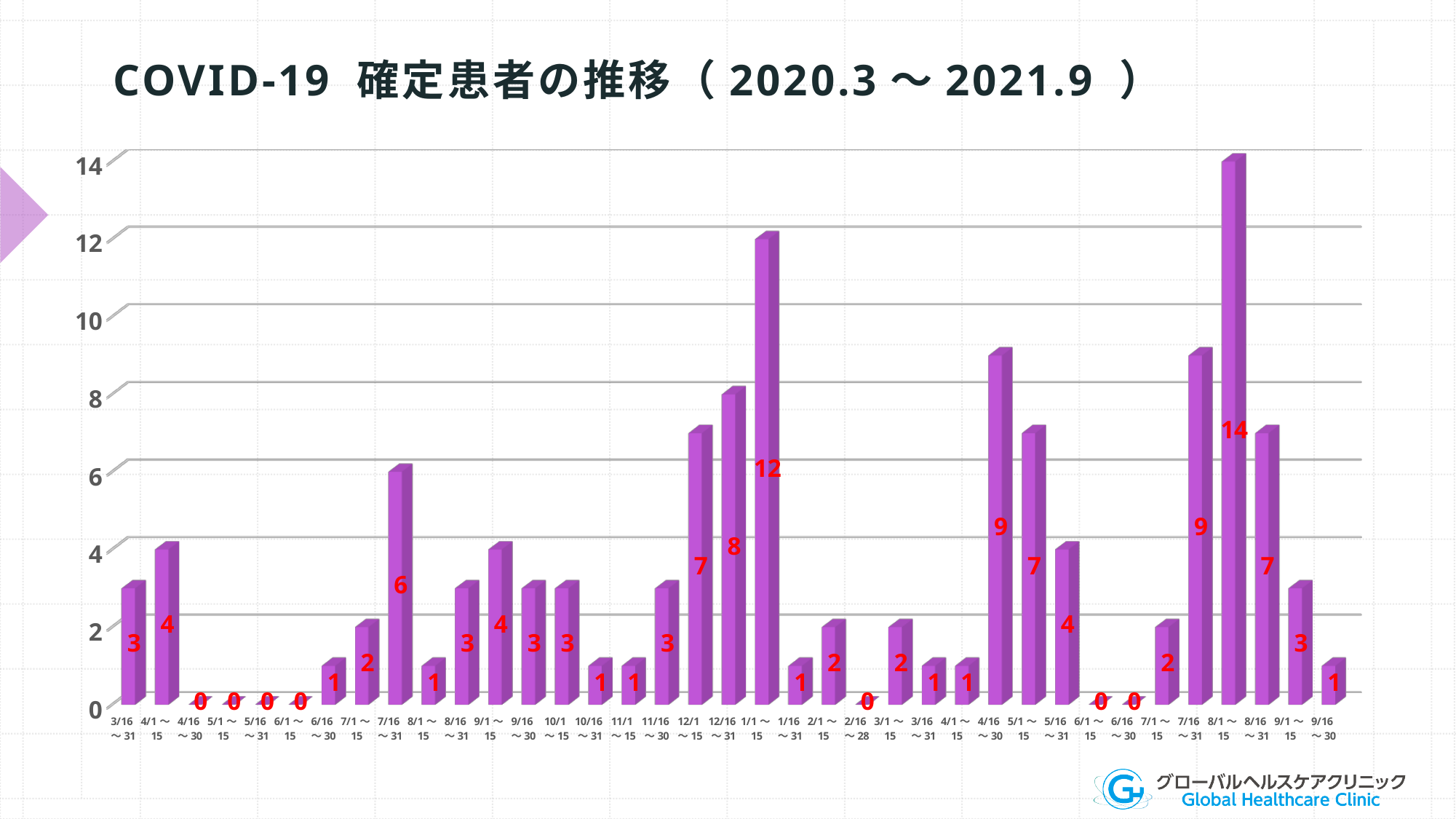
What is the value for the period 2/16〜28? 0 What is the difference between the values for 12/16〜31 and 12/1〜15? 1 What is the value for the period 10/1〜15? 3 What is the value for the period 12/16〜31? 8 Is the value for 1/1〜15 greater or less than 10? greater How many periods have a value of 0? 7 Which period has the highest value, and what is it? 8/1〜15 (2021), 14 What is the value for the period 1/1〜15? 12 What is the difference between the values for 1/1〜15 and 1/16〜31? 11 What kind of chart is shown on the slide? bar chart Which is larger, the value for 12/1〜15 or the value for 11/16〜30? 12/1〜15 How many periods (bars) are shown on the x axis? 37